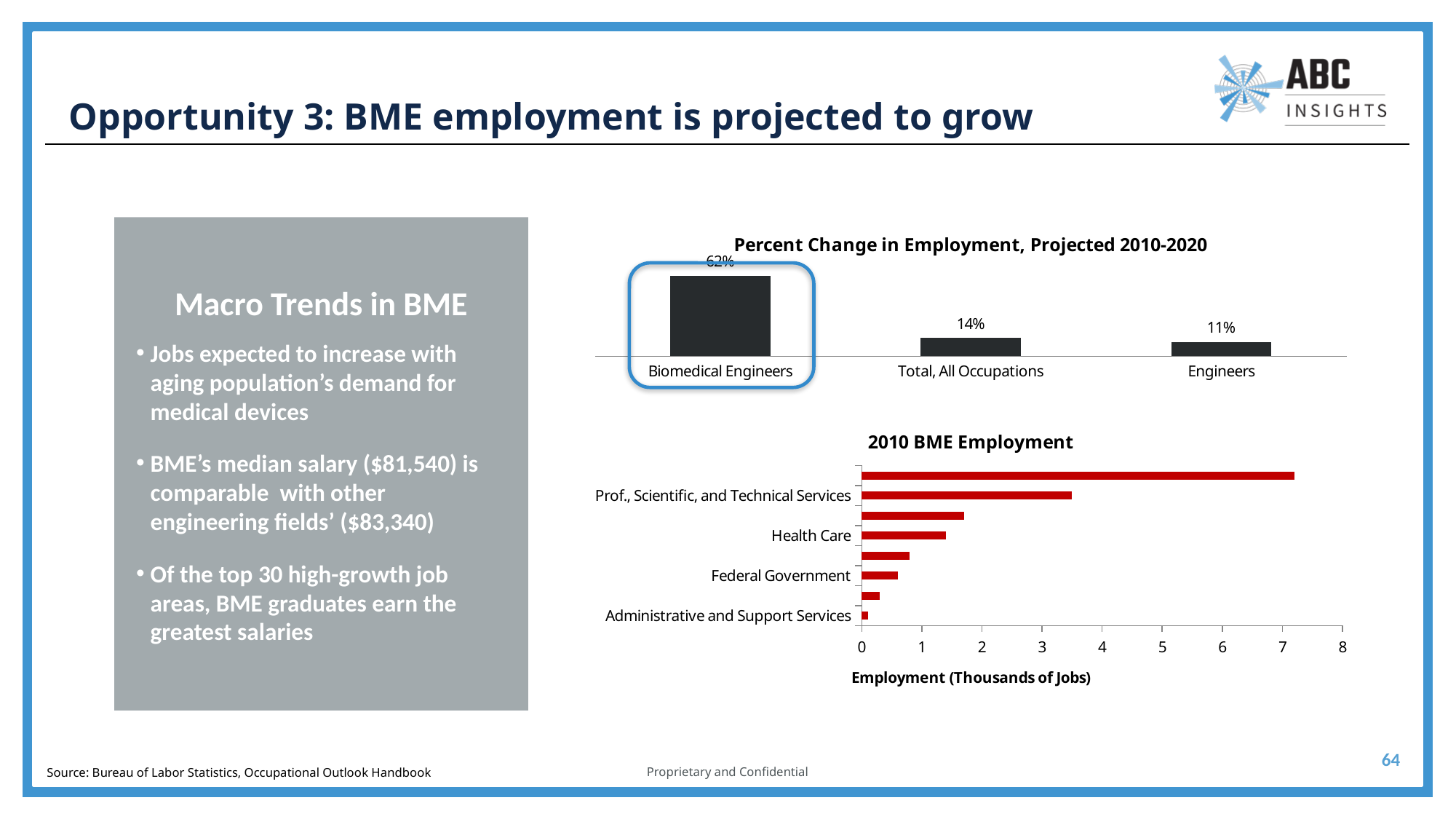
In the 'Percent Change in Employment, Projected 2010-2020' chart, what is the value for Engineers? 11% In the '2010 BME Employment' chart, what is the label on the horizontal axis? Employment (Thousands of Jobs) In the '2010 BME Employment' chart, which is larger, Health Care or Federal Government? Health Care In the 'Percent Change in Employment, Projected 2010-2020' chart, which category has the lowest value? Engineers In the 'Percent Change in Employment, Projected 2010-2020' chart, what is the value for Biomedical Engineers? 62% In the 'Percent Change in Employment, Projected 2010-2020' chart, what is the value for Total, All Occupations? 14% What kind of chart is the '2010 BME Employment' chart? Bar chart In the 'Percent Change in Employment, Projected 2010-2020' chart, which category has the highest value? Biomedical Engineers In the '2010 BME Employment' chart, is the value for Prof., Scientific, and Technical Services greater or less than 3? greater In the '2010 BME Employment' chart, is the value for Health Care greater or less than 2? less In the 'Percent Change in Employment, Projected 2010-2020' chart, how many categories are shown? 3 In the 'Percent Change in Employment, Projected 2010-2020' chart, what is the difference between Biomedical Engineers and Total, All Occupations? 48%